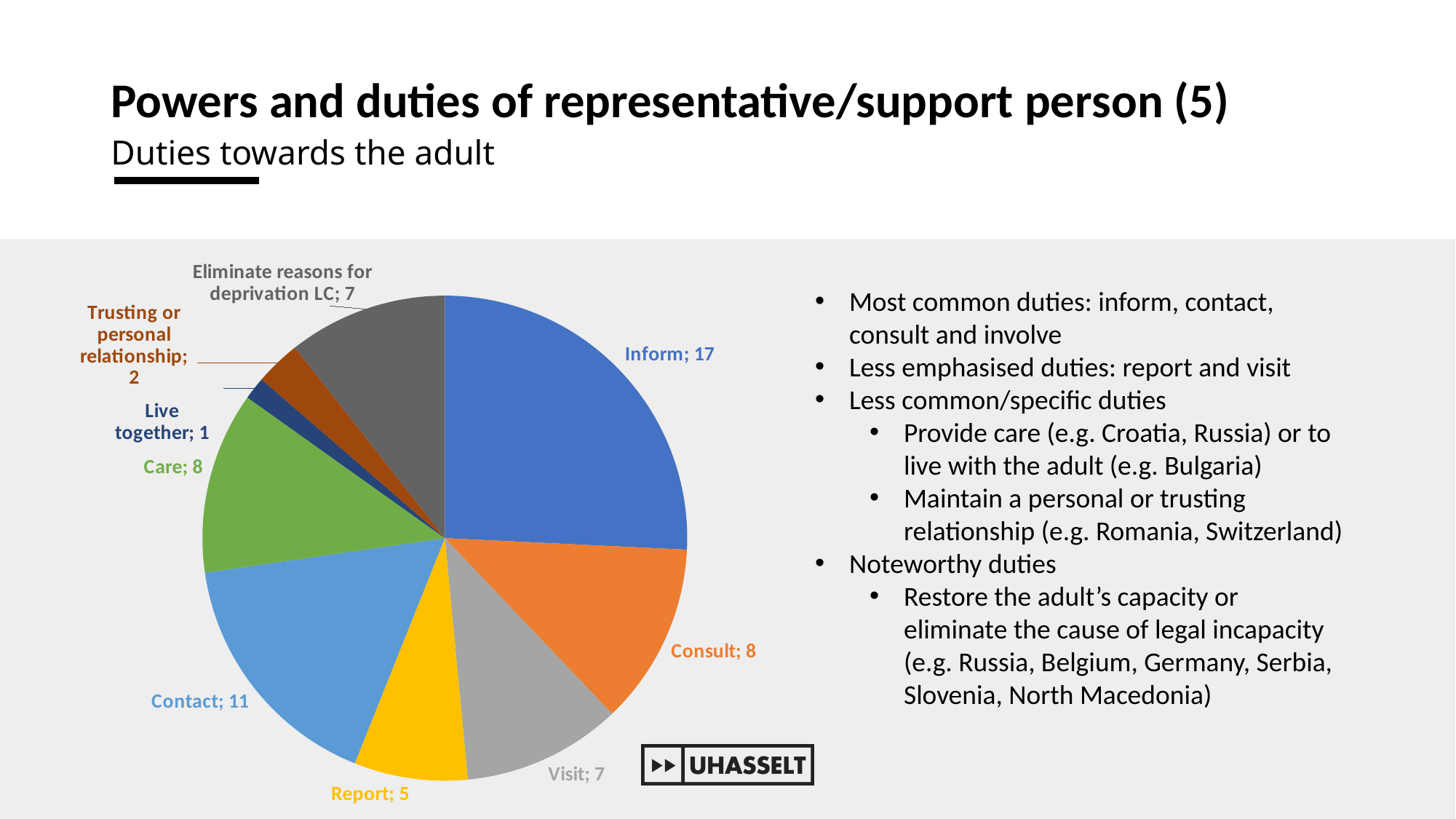
Do Consult and Care have the same value in the pie chart? Yes, both are 8 How many slices does the pie chart have? 9 Which is larger, the value for Contact or the value for Care? Contact What type of chart is shown on the slide? Pie chart Which duty has the smallest slice in the pie chart? Live together What is the value for Trusting or personal relationship? 2 What is the difference between the values for Inform and Contact? 6 Which duty has the largest slice in the pie chart? Inform What is the value for Eliminate reasons for deprivation LC? 7 What is the value for Report in the pie chart? 5 What is the total of all the values shown in the pie chart? 66 What is the value for Contact in the pie chart? 11